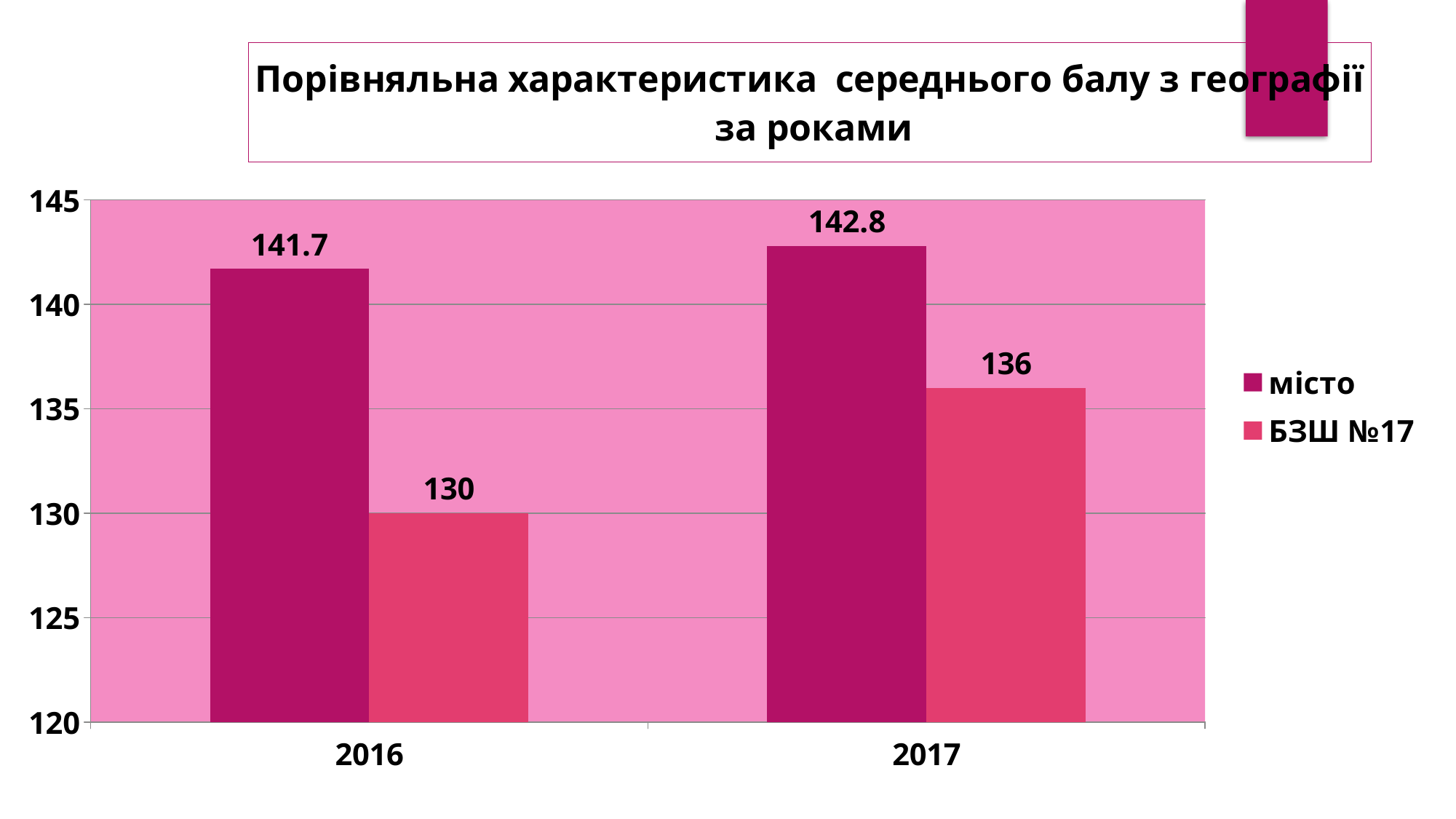
What kind of chart is shown on the slide? bar chart What is the value for БЗШ №17 in 2017? 136 Which is larger in 2017, місто or БЗШ №17? місто What is the value for БЗШ №17 in 2016? 130 What is the difference between місто and БЗШ №17 in 2017? 6.8 What is the value for місто in 2017? 142.8 What is the difference between місто and БЗШ №17 in 2016? 11.7 Which year has the higher value for БЗШ №17? 2017 Does the value for БЗШ №17 rise or fall from 2016 to 2017? rise What is the value for місто in 2016? 141.7 Which bar has the lowest value on the chart? БЗШ №17 in 2016 How many series does the legend list? 2